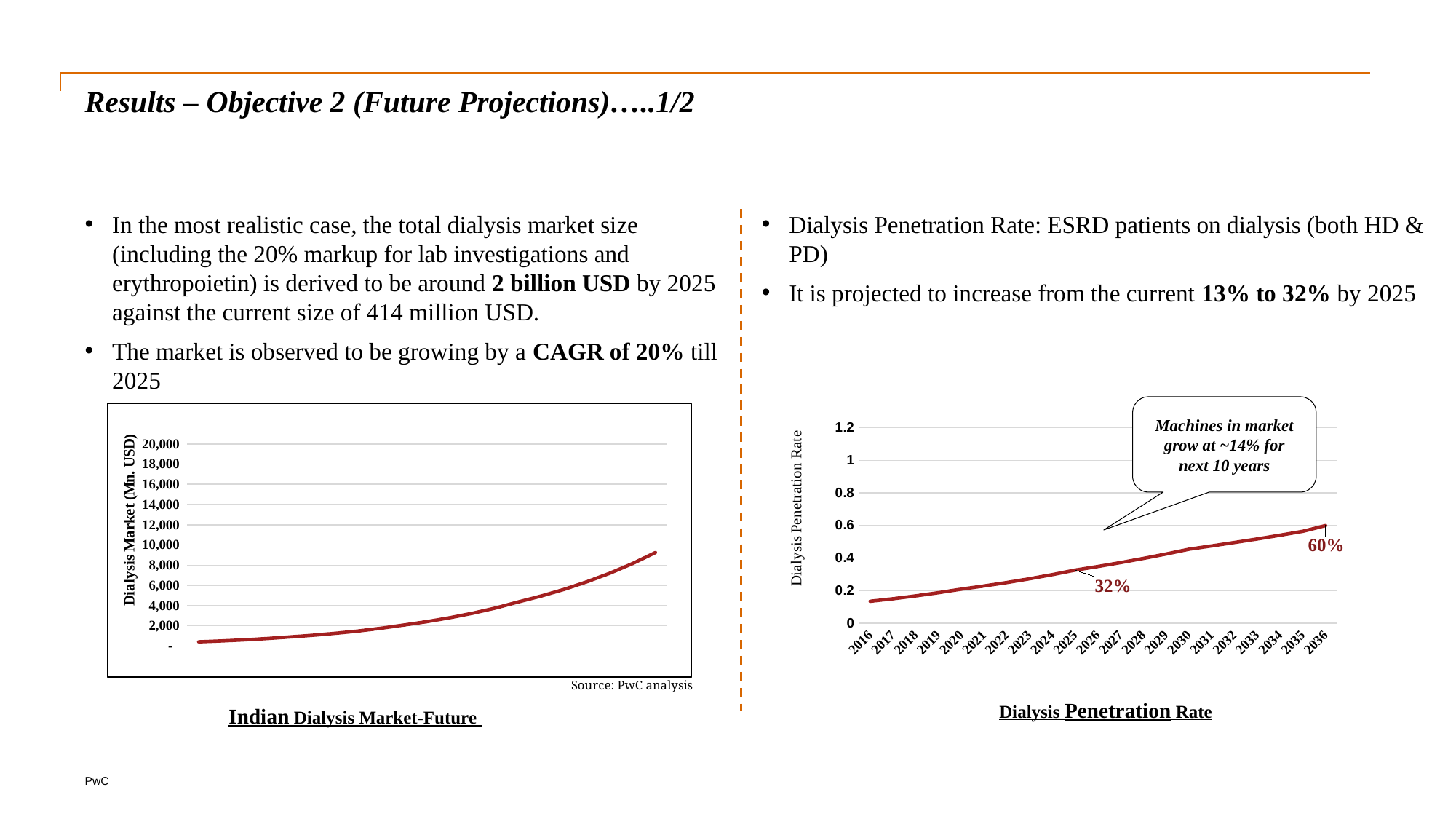
What kind of chart is the Indian Dialysis Market-Future chart on the left? line chart Do the values in the Dialysis Penetration Rate chart rise or fall from 2016 to 2036? rise What kind of chart is the Dialysis Penetration Rate chart on the right? line chart In the Dialysis Penetration Rate chart, what value is labelled for 2025? 32% How many years are shown on the x axis of the Dialysis Penetration Rate chart? 21 In the Dialysis Penetration Rate chart, is the value for 2016 greater or less than 0.2? less What is the y-axis label of the Indian Dialysis Market-Future chart? Dialysis Market (Mn. USD) In the Dialysis Penetration Rate chart, which year has the higher value, 2025 or 2036? 2036 In the Indian Dialysis Market-Future chart, is the final value of the line greater or less than 8,000? greater In the Dialysis Penetration Rate chart, which year has the lowest value? 2016 In the Dialysis Penetration Rate chart, what value is labelled for 2036? 60% In the Dialysis Penetration Rate chart, what is the difference between the labelled values for 2036 and 2025? 28%